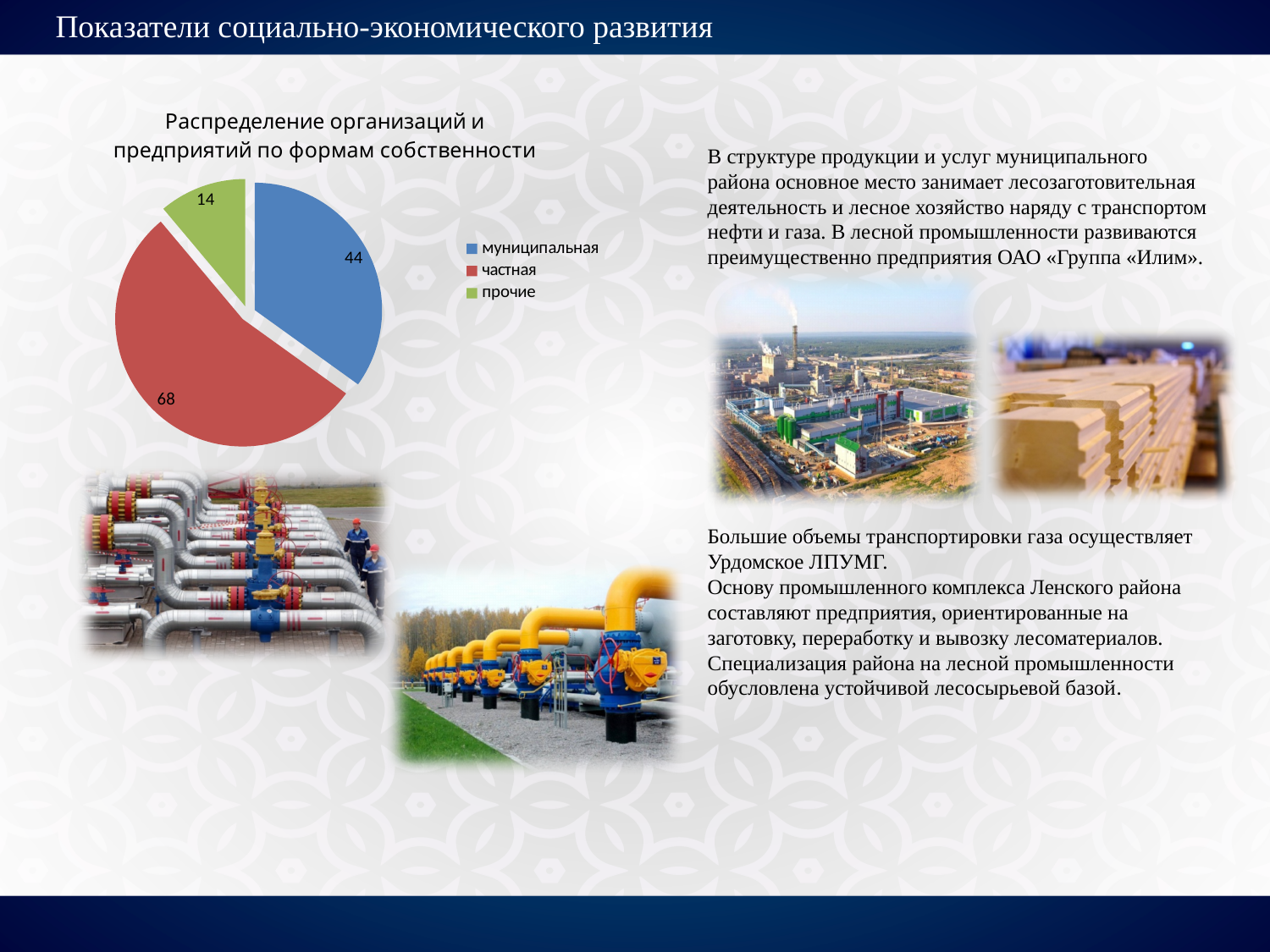
What is the value for the "муниципальная" slice in the pie chart? 44 Which form of ownership has the smallest slice in the pie chart? прочие What is the difference between the "муниципальная" and "прочие" values in the pie chart? 30 What is the difference between the "частная" and "муниципальная" values in the pie chart? 24 What is the value for the "прочие" slice in the pie chart? 14 What is the value for the "частная" slice in the pie chart? 68 How many slices does the pie chart have? 3 Which is larger in the pie chart, "муниципальная" or "прочие"? муниципальная What is the title of the pie chart? Распределение организаций и предприятий по формам собственности What kind of chart is shown on the slide? pie chart What is the sum of all three values shown in the pie chart? 126 Which form of ownership has the largest slice in the pie chart? частная